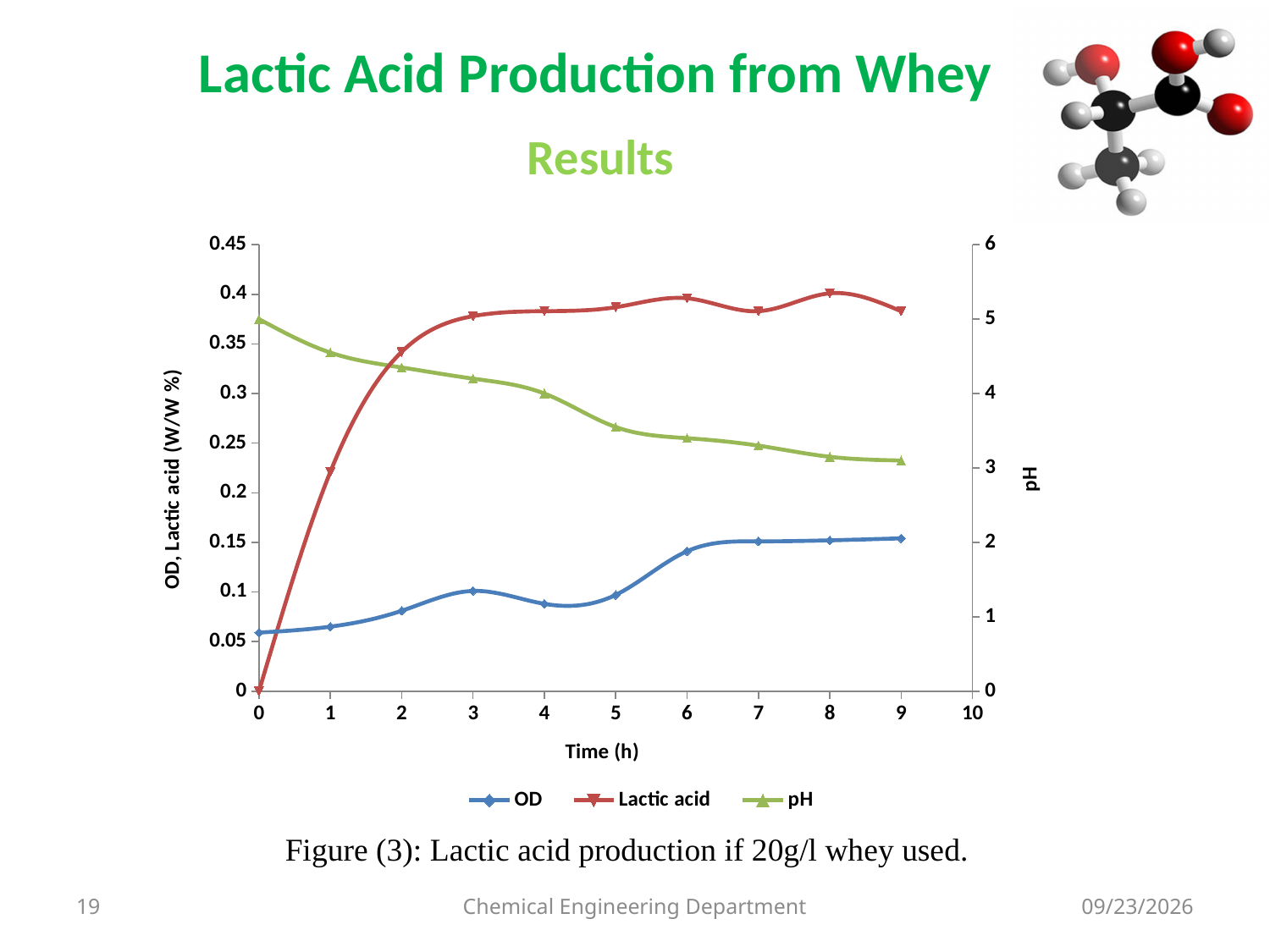
Is the OD value at 6 h greater or less than 0.15? less Is the Lactic acid value at 1 h greater or less than 0.25? less What is the Lactic acid value at time 0 h? 0 What kind of chart is shown on the slide? line chart Does the pH series rise or fall as time increases? fall Is the pH value at 5 h greater or less than 4? less At 3 h, which is larger: the Lactic acid value or the OD value? Lactic acid What is the title of the x axis? Time (h) How many series does the legend list? 3